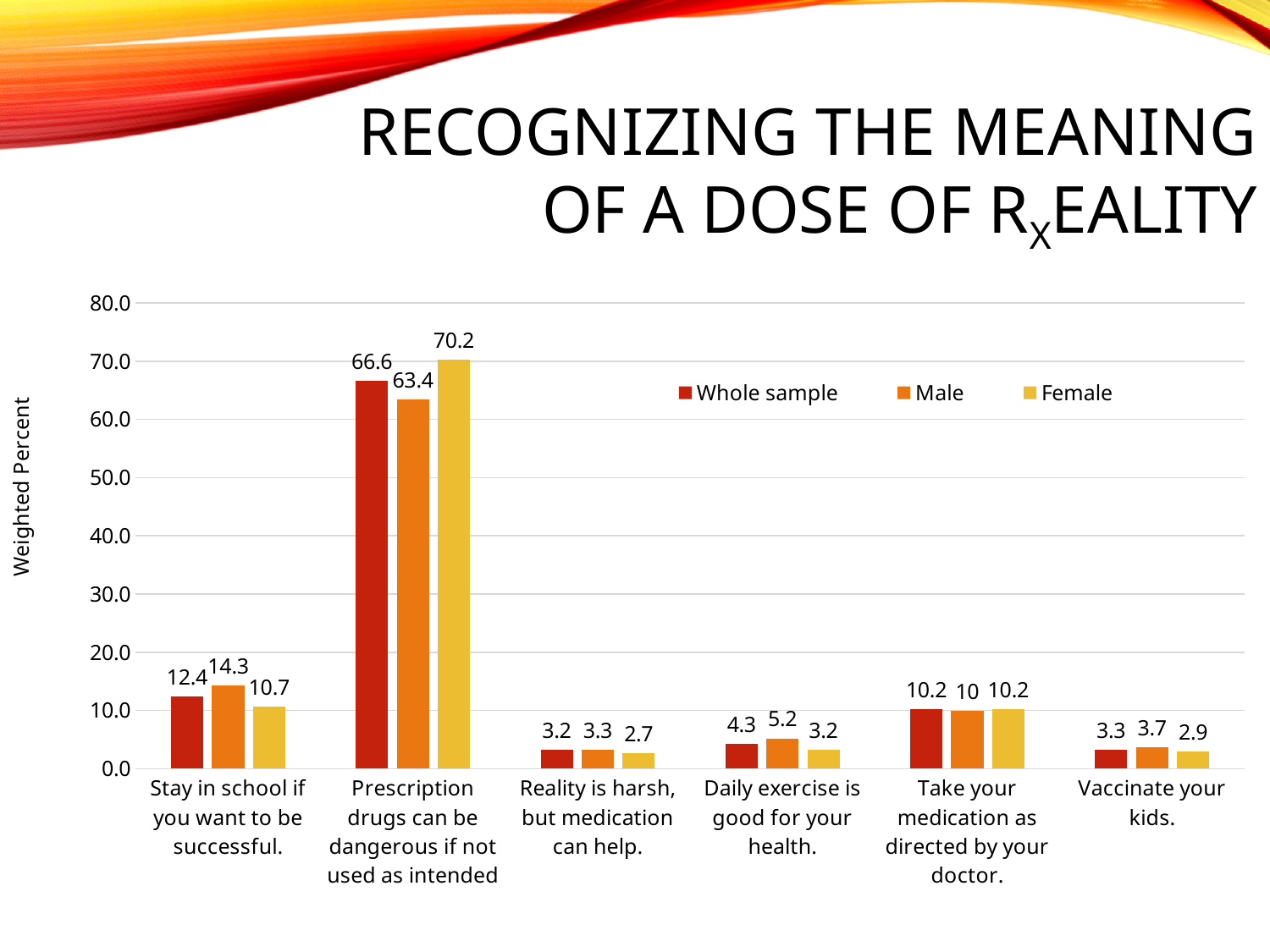
What is the Female value for "Prescription drugs can be dangerous if not used as intended"? 70.2 What is the Whole sample value for "Stay in school if you want to be successful."? 12.4 What kind of chart is shown on the slide? Bar chart What is the Male value for "Daily exercise is good for your health."? 5.2 What is the difference between the Female and Male values for "Prescription drugs can be dangerous if not used as intended"? 6.8 How many categories are shown on the x axis? 6 Which category has the highest Whole sample value? Prescription drugs can be dangerous if not used as intended Is the Whole sample value for "Prescription drugs can be dangerous if not used as intended" greater or less than 60.0? greater How many series does the legend list? 3 Which category has the lowest Female value? Reality is harsh, but medication can help. What is the label of the y axis? Weighted Percent For "Stay in school if you want to be successful.", which is larger, the Male value or the Female value? Male